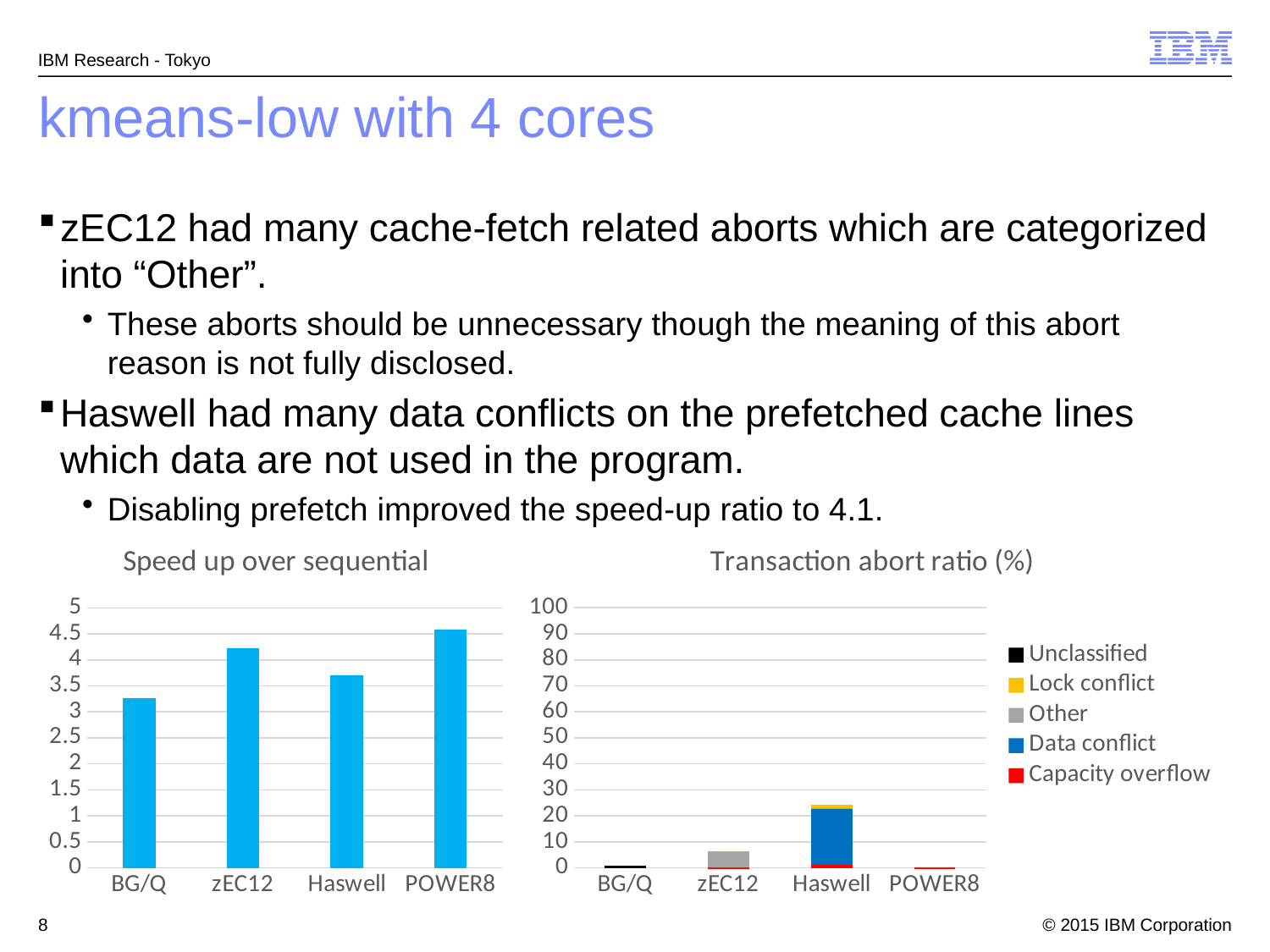
In the "Transaction abort ratio (%)" chart, which category has the highest total abort ratio? Haswell In the "Speed up over sequential" chart, which category has the lowest speed-up? BG/Q In the "Speed up over sequential" chart, which category has the highest speed-up? POWER8 In the "Transaction abort ratio (%)" chart, is the total abort ratio for zEC12 greater or less than 10? less What kind of chart is the "Speed up over sequential" chart? bar chart In the "Speed up over sequential" chart, is the value for zEC12 greater or less than 4? greater In the "Transaction abort ratio (%)" chart, is the total abort ratio for Haswell greater or less than 20? greater In the "Transaction abort ratio (%)" chart, which legend entry is shown in red? Capacity overflow How many categories are shown on the x axis of the "Speed up over sequential" chart? 4 How many series does the legend of the "Transaction abort ratio (%)" chart list? 5 In the "Speed up over sequential" chart, which is larger, the value for zEC12 or the value for Haswell? zEC12